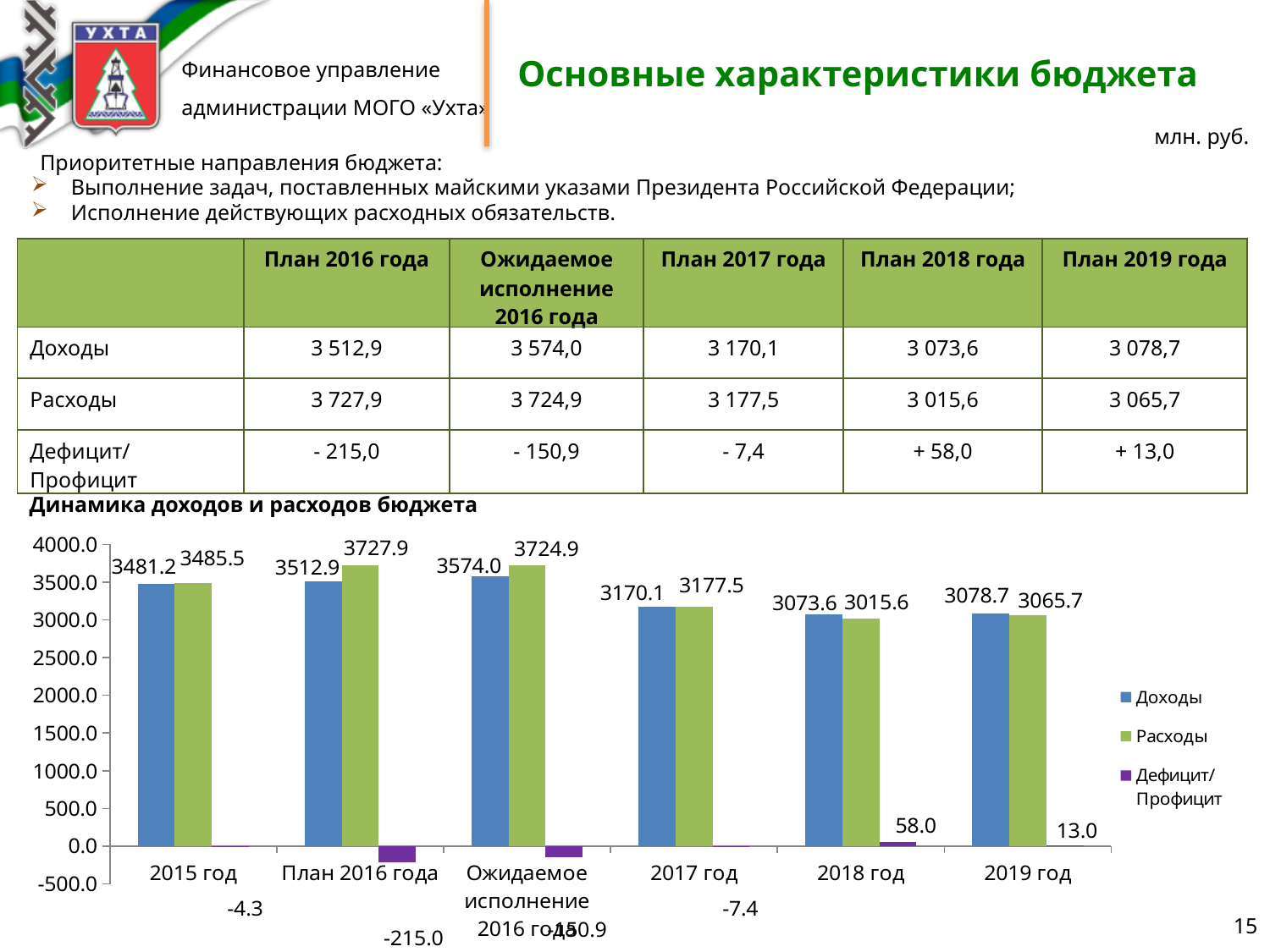
What is the value of Расходы for План 2016 года in the chart? 3727.9 How many categories are shown along the x axis of the chart? 6 Which category has the highest Расходы value in the chart? План 2016 года What colour are the Расходы bars in the chart? green How many series does the legend of the chart list? 3 Which is larger in the chart for 2018 год: Доходы or Расходы? Доходы What is the value of Доходы for 2015 год in the chart? 3481.2 What kind of chart is shown under the heading "Динамика доходов и расходов бюджета"? bar chart Do the Доходы values rise or fall from Ожидаемое исполнение 2016 года to 2018 год in the chart? fall What is the difference between Расходы and Доходы for Ожидаемое исполнение 2016 года in the chart? 150.9 What is the value of Дефицит/Профицит for 2018 год in the chart? 58.0 Which category has the lowest Доходы value in the chart? 2018 год